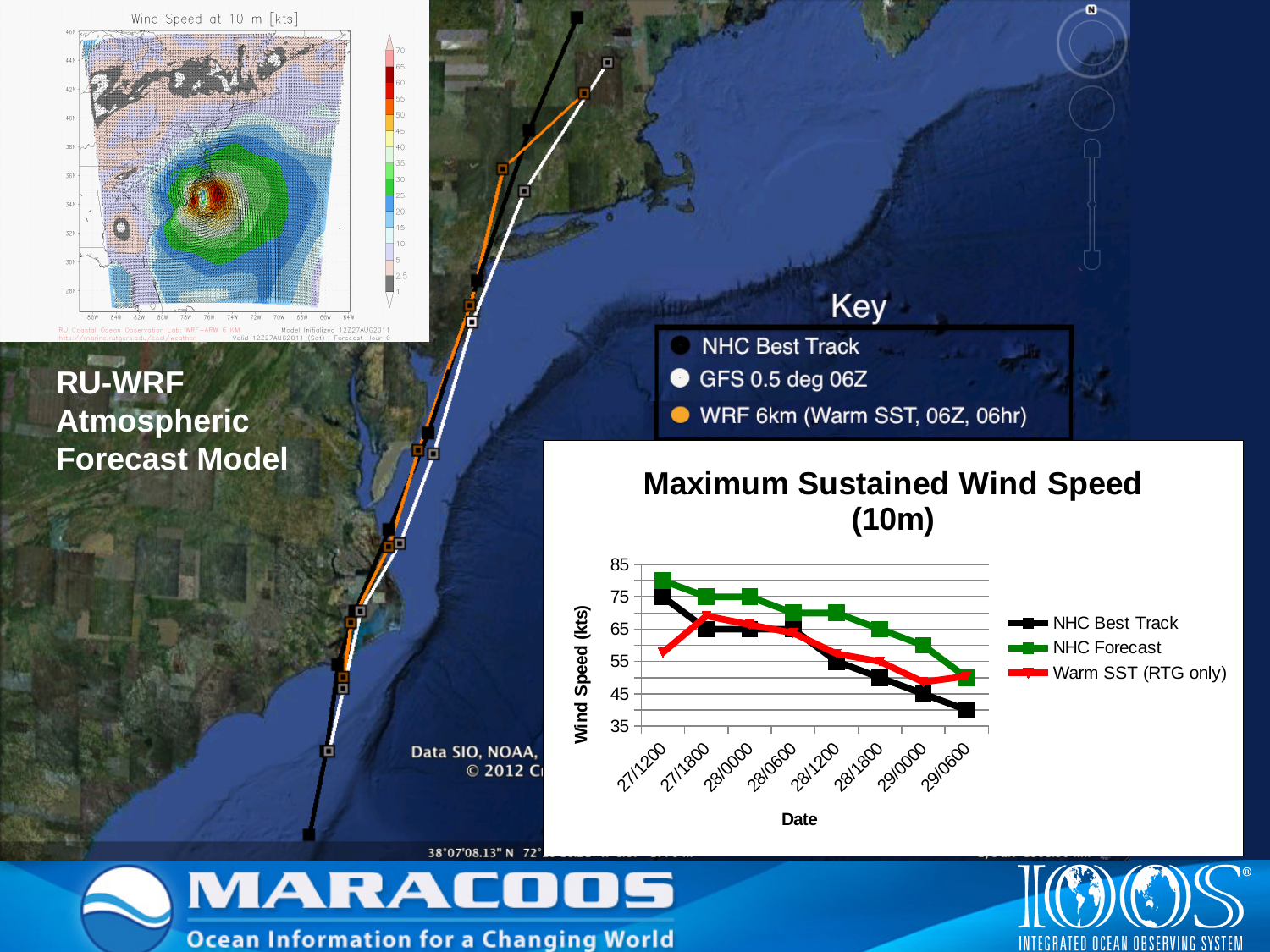
In the "Maximum Sustained Wind Speed (10m)" chart, which series has the lowest value at 29/0600? NHC Best Track In the "Maximum Sustained Wind Speed (10m)" chart, at 27/1200 which is larger: NHC Best Track or Warm SST (RTG only)? NHC Best Track What is the x-axis title of the "Maximum Sustained Wind Speed (10m)" chart? Date In the "Maximum Sustained Wind Speed (10m)" chart, is the NHC Forecast value at 27/1200 greater or less than 75? greater In the "Maximum Sustained Wind Speed (10m)" chart, is the Warm SST (RTG only) value at 29/0000 greater or less than 55? less In the "Maximum Sustained Wind Speed (10m)" chart, is the NHC Best Track value at 29/0600 greater or less than 45? less How many dates are shown on the x axis of the "Maximum Sustained Wind Speed (10m)" chart? 8 In the "Maximum Sustained Wind Speed (10m)" chart, which series has the highest value at 27/1200? NHC Forecast What is the y-axis title of the "Maximum Sustained Wind Speed (10m)" chart? Wind Speed (kts) How many series does the legend of the "Maximum Sustained Wind Speed (10m)" chart list? 3 In the "Maximum Sustained Wind Speed (10m)" chart, does the NHC Best Track series rise or fall from 27/1200 to 29/0600? fall What kind of chart is the "Maximum Sustained Wind Speed (10m)" chart? line chart